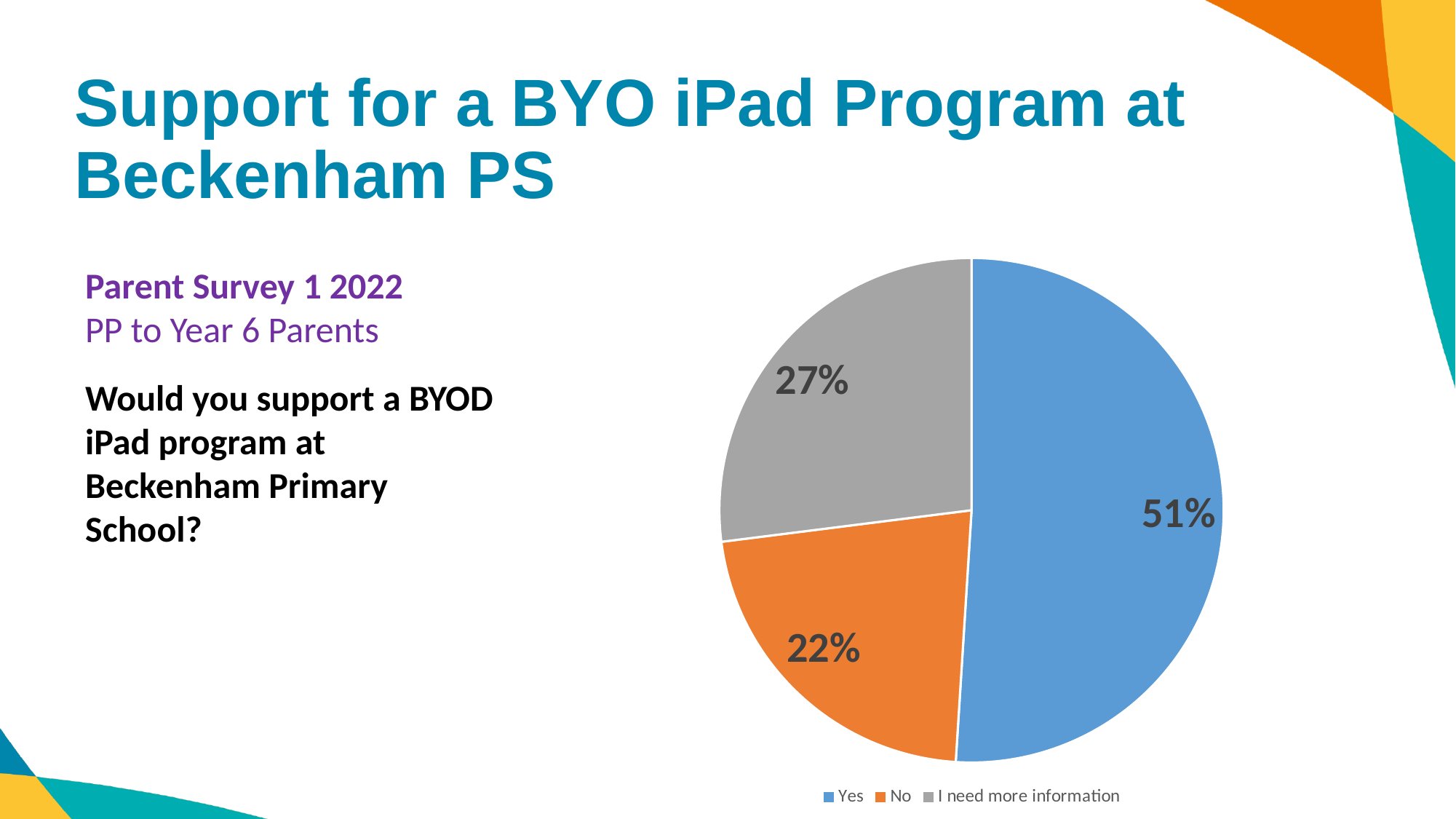
What is the difference in percentage points between "Yes" and "No"? 29 Which response has the largest share of the pie? Yes How many slices does the pie chart have? 3 What is the difference in percentage points between "I need more information" and "No"? 5 What colour is the "Yes" slice? blue Which response has the smallest share of the pie? No Which is larger, the share for "No" or the share for "I need more information"? I need more information What kind of chart is shown on the slide? pie chart What percentage of parents answered "No"? 22% What percentage of parents answered "Yes"? 51% How many entries does the legend list? 3 What percentage of parents answered "I need more information"? 27%